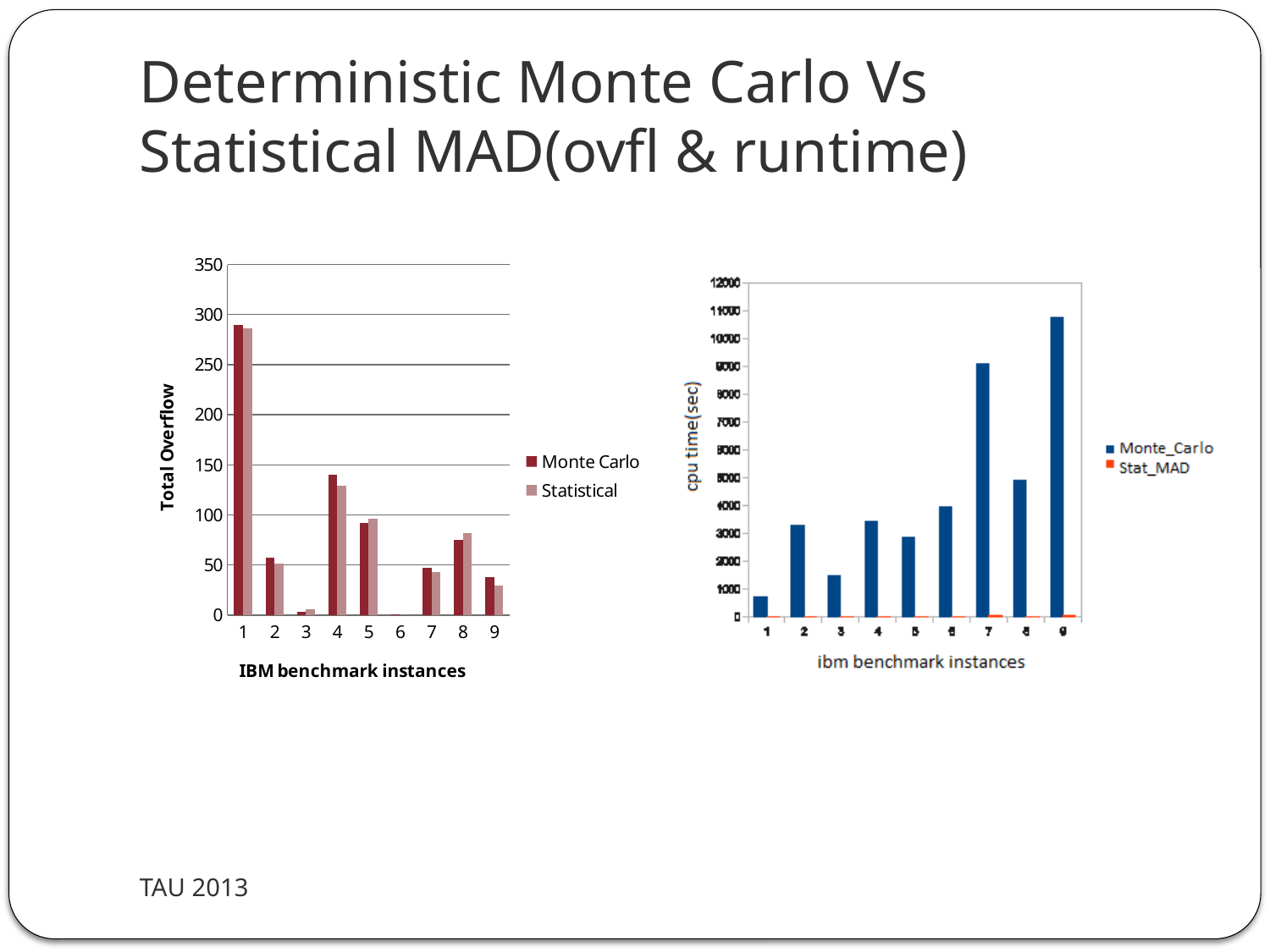
On the right chart (cpu time), which ibm benchmark instance has the highest Monte_Carlo cpu time? 9 On the left chart (Total Overflow), which IBM benchmark instance has the highest Monte Carlo value? 1 On the right chart (cpu time), which instance has the larger Monte_Carlo cpu time, instance 6 or instance 8? 8 On the left chart (Total Overflow), is the Monte Carlo value for instance 2 greater or less than 100? less On the left chart (Total Overflow), how many series does the legend list? 2 On the left chart (Total Overflow), how many IBM benchmark instances are shown on the x axis? 9 On the right chart (cpu time), which ibm benchmark instance has the lowest Monte_Carlo cpu time? 1 On the left chart (Total Overflow), which IBM benchmark instance has the lowest Monte Carlo value? 6 What type of chart is the right chart (cpu time)? bar chart On the left chart (Total Overflow), is the Monte Carlo value for instance 1 greater or less than 250? greater On the right chart (cpu time), is the Monte_Carlo value for instance 7 greater or less than 8000? greater On the left chart (Total Overflow), for instance 4, which series has the larger value, Monte Carlo or Statistical? Monte Carlo